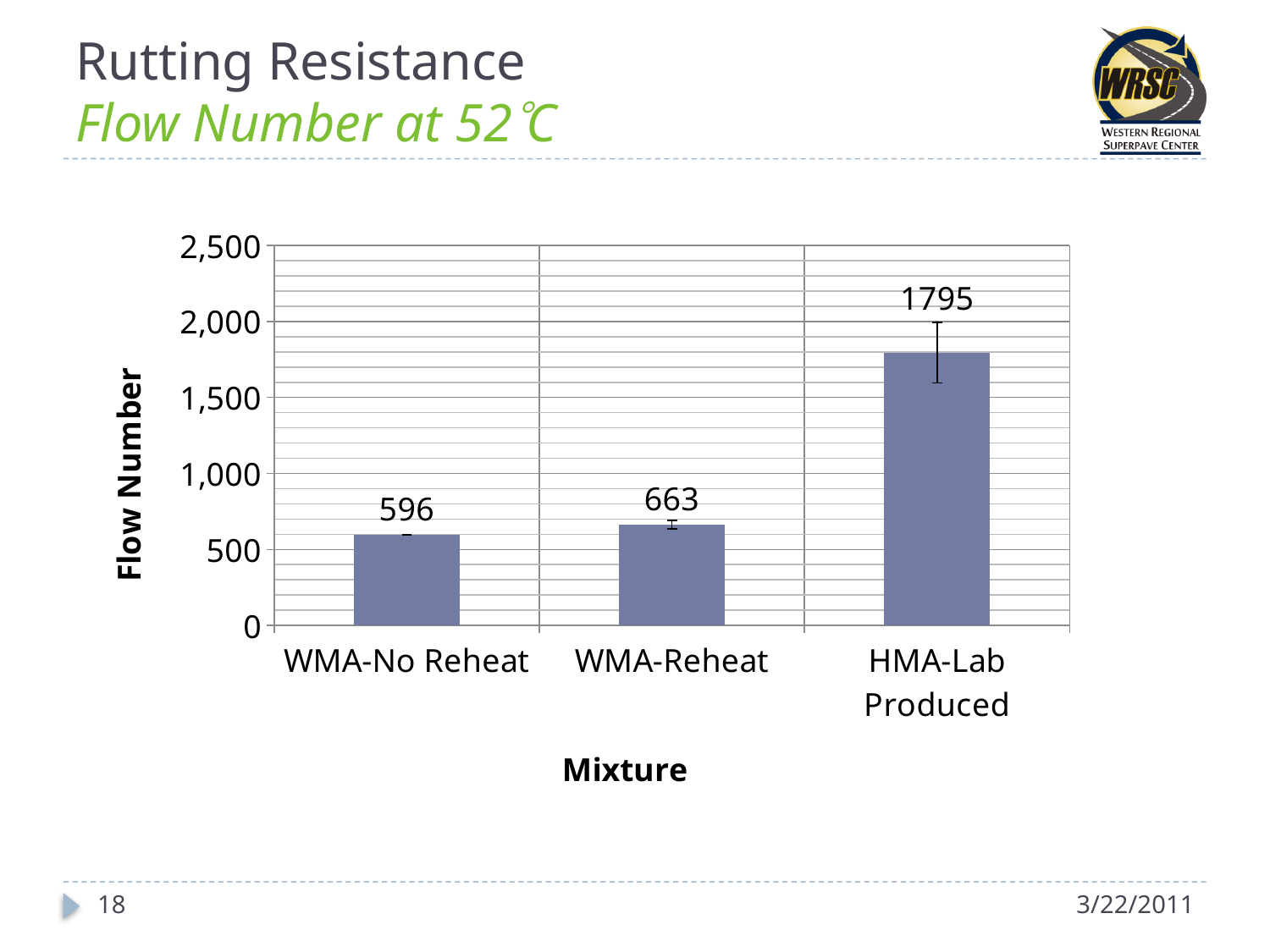
Is the Flow Number for HMA-Lab Produced greater or less than 1,500? greater Which mixture has the highest Flow Number? HMA-Lab Produced Which has a larger Flow Number, WMA-Reheat or WMA-No Reheat? WMA-Reheat What is the Flow Number for HMA-Lab Produced? 1795 What is the label of the x axis? Mixture What is the difference in Flow Number between WMA-Reheat and WMA-No Reheat? 67 What kind of chart is shown on the slide? bar chart What is the difference in Flow Number between HMA-Lab Produced and WMA-Reheat? 1132 What is the Flow Number for WMA-No Reheat? 596 What is the Flow Number for WMA-Reheat? 663 How many mixtures are shown on the chart? 3 Which mixture has the lowest Flow Number? WMA-No Reheat